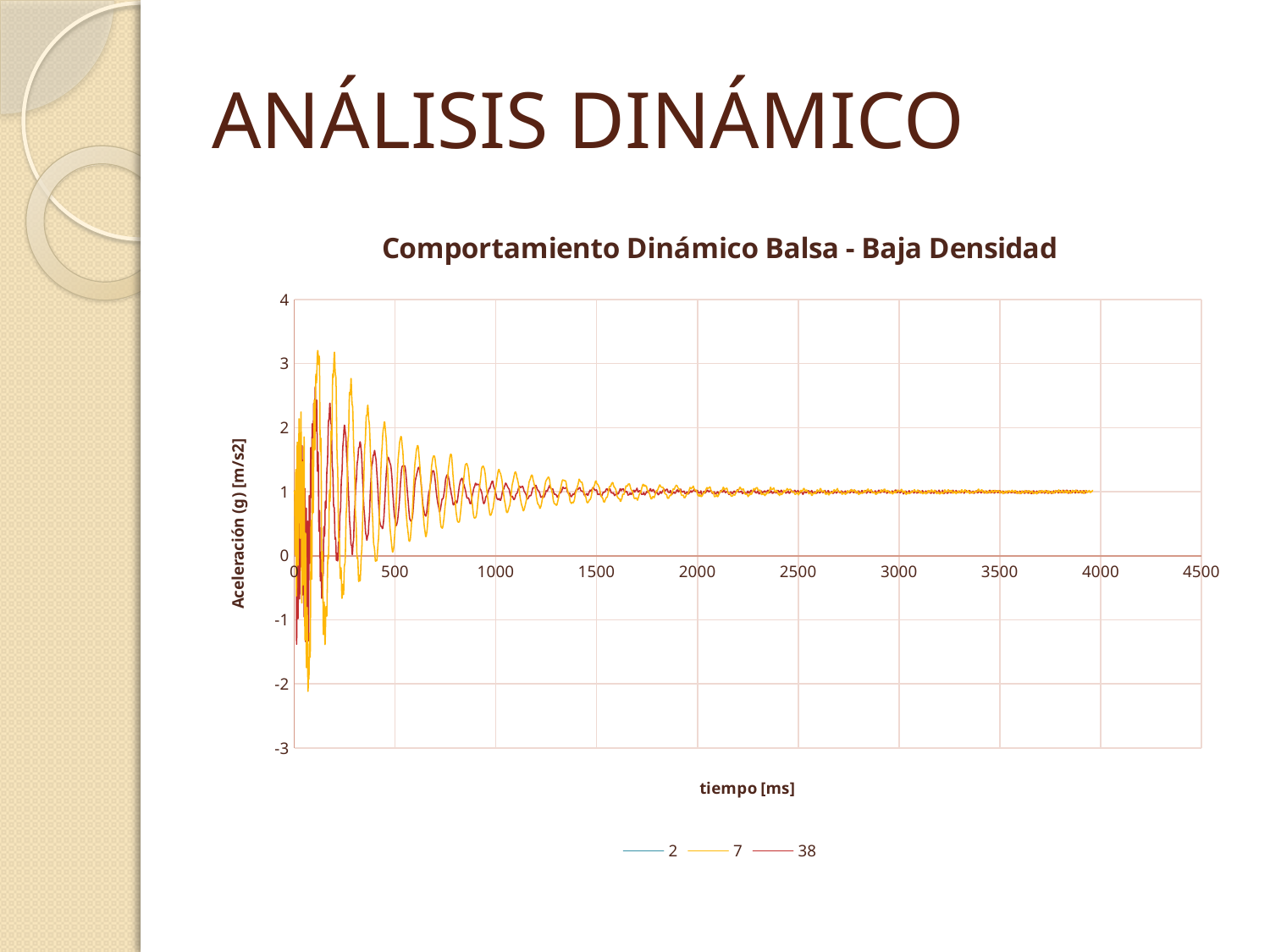
What is the label of the x axis? tiempo [ms] How many series does the chart's legend list? 3 Around 3000 ms, are the series values greater or less than 2? less What is the label of the y axis? Aceleración (g) [m/s2] Does the amplitude of the oscillations increase or decrease as time increases along the x axis? decrease What kind of chart is shown on the slide? line chart What is the title of the chart? Comportamiento Dinámico Balsa - Baja Densidad What is the largest tick value shown on the x axis? 4500 What is the minimum value shown on the y axis? -3 What is the maximum value shown on the y axis? 4 Is the highest peak reached by the series greater or less than 2? greater What are the series names listed in the legend? 2, 7, 38